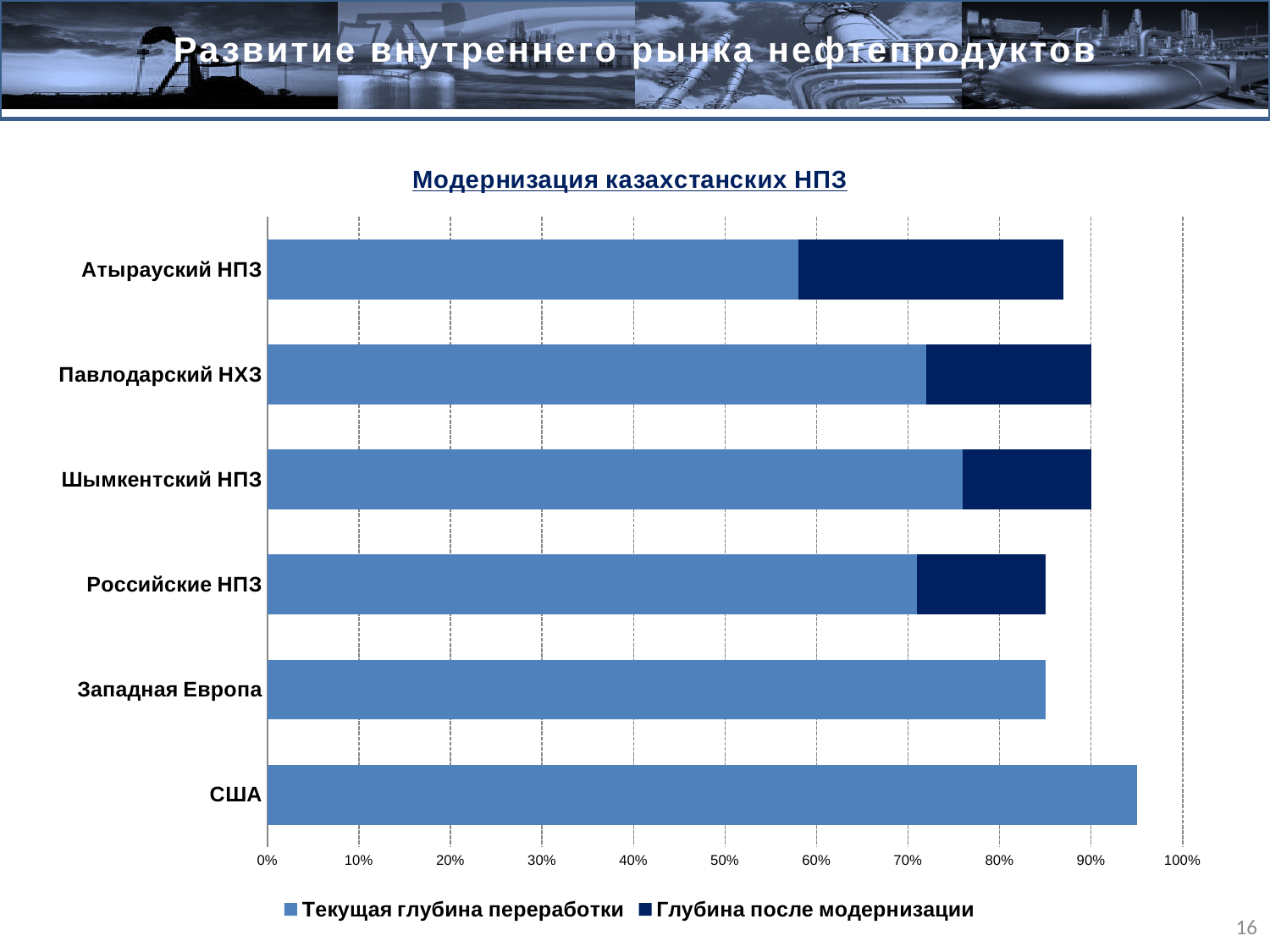
Which category has the longest bar overall? США Which is larger, the bar for США or the bar for Западная Европа? США What is the title of the chart? Модернизация казахстанских НПЗ What kind of chart is shown on the slide? Bar chart Is the value for США greater or less than 90%? greater Which is larger for Текущая глубина переработки, Атырауский НПЗ or Шымкентский НПЗ? Шымкентский НПЗ How many categories are shown on the chart? 6 Which category has the lowest value for Текущая глубина переработки? Атырауский НПЗ Is the Текущая глубина переработки value for Шымкентский НПЗ greater or less than 70%? greater Is the Текущая глубина переработки value for Атырауский НПЗ greater or less than 70%? less How many series does the legend list? 2